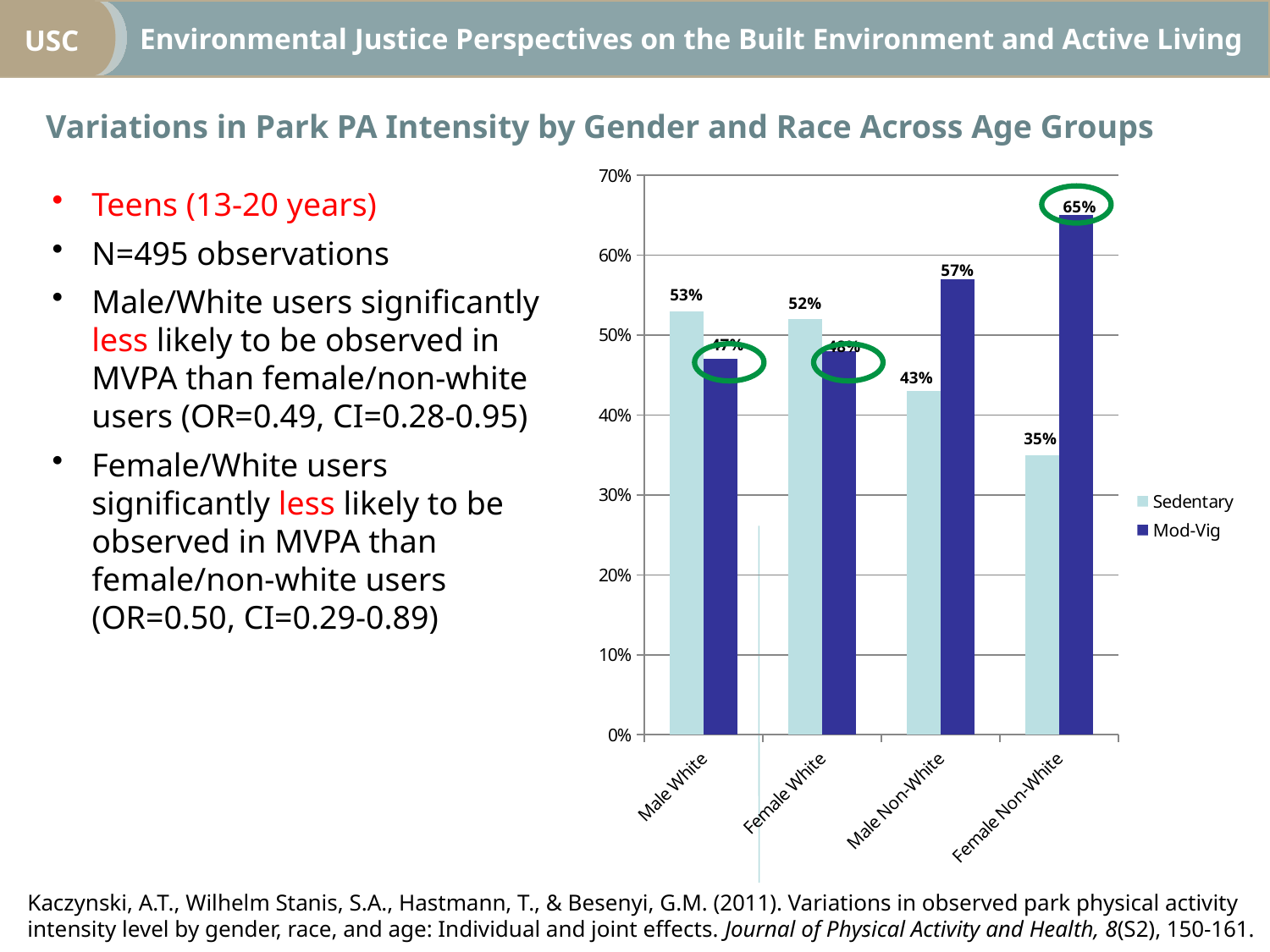
Is the Mod-Vig value for Male White greater or less than 50%? less What is the Mod-Vig value for Male Non-White? 57% What is the Sedentary value for Male White? 53% What is the Sedentary value for Male Non-White? 43% How many categories are shown on the x axis? 4 Which series is shown in dark blue in the legend? Mod-Vig Which category has the lowest Sedentary value? Female Non-White Which category has the highest Mod-Vig value? Female Non-White What type of chart is shown on the slide? bar chart What is the Mod-Vig value for Female Non-White? 65% How many series does the legend list? 2 What is the difference between the Mod-Vig value for Female Non-White and the Mod-Vig value for Male Non-White? 8%